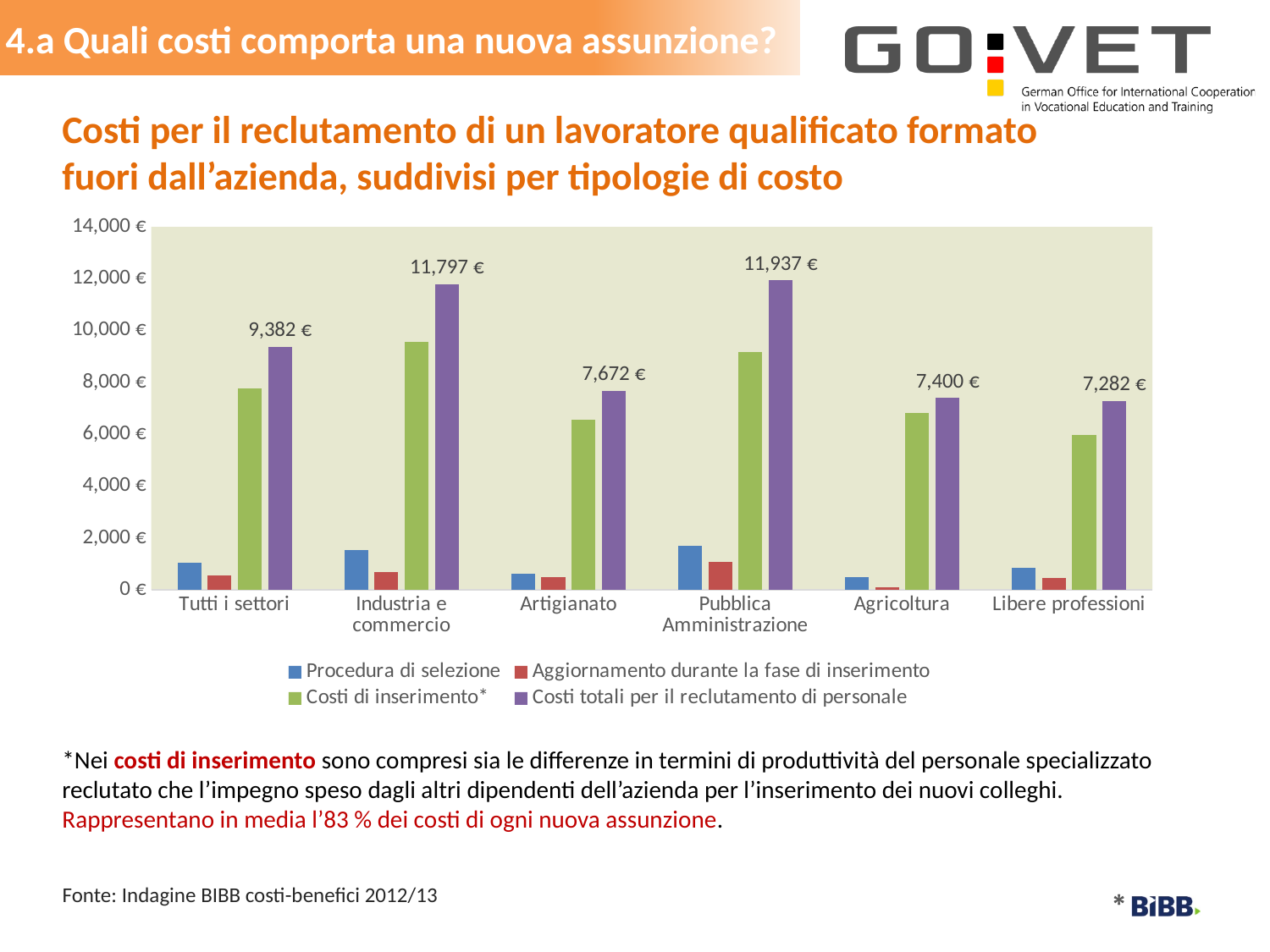
Which category has the lowest 'Costi totali per il reclutamento di personale'? Libere professioni What is the value of 'Costi totali per il reclutamento di personale' for Industria e commercio? 11,797 € What is the value of 'Costi totali per il reclutamento di personale' for Tutti i settori? 9,382 € Is the value of 'Procedura di selezione' for Pubblica Amministrazione greater or less than 2,000 €? less What is the value of 'Costi totali per il reclutamento di personale' for Agricoltura? 7,400 € Is the value of 'Costi di inserimento*' for Industria e commercio greater or less than 8,000 €? greater How many categories are shown on the x axis? 6 Which has larger 'Costi di inserimento*': Industria e commercio or Artigianato? Industria e commercio What is the difference in 'Costi totali per il reclutamento di personale' between Pubblica Amministrazione and Tutti i settori? 2,555 € Which category has the highest 'Costi totali per il reclutamento di personale'? Pubblica Amministrazione How many series does the legend list? 4 What kind of chart is shown on the slide? Bar chart